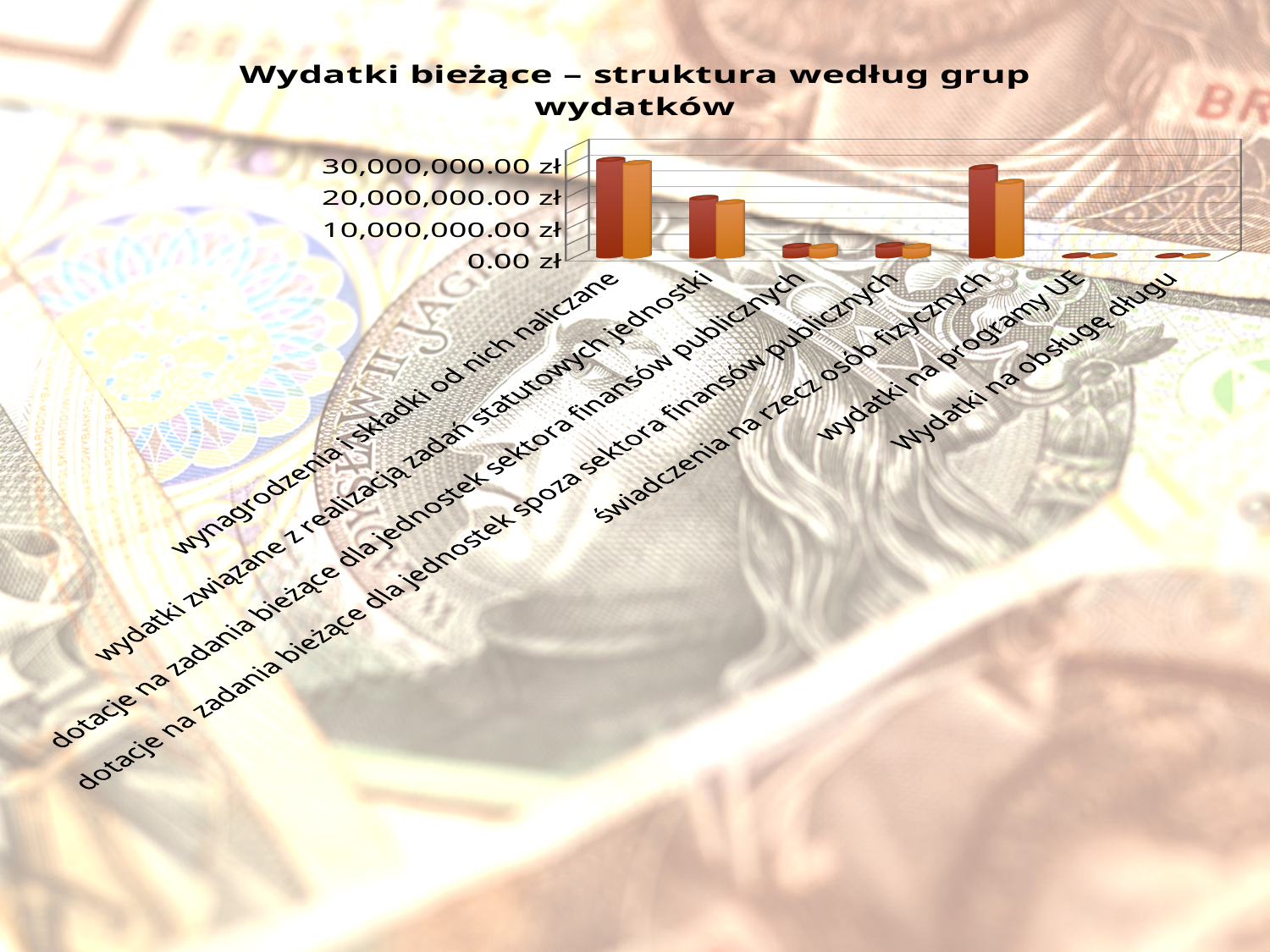
Which is larger: the value for 'wynagrodzenia i składki od nich naliczane' or for 'wydatki związane z realizacją zadań statutowych jednostki'? wynagrodzenia i składki od nich naliczane Which category has the highest bars in the chart? wynagrodzenia i składki od nich naliczane Is the value for 'świadczenia na rzecz osób fizycznych' greater or less than 10,000,000.00 zł? greater What is the title of the chart? Wydatki bieżące – struktura według grup wydatków Which category has the lowest bars in the chart? Wydatki na obsługę długu Is the value for 'wydatki na programy UE' greater or less than 20,000,000.00 zł? less How many expenditure categories are shown on the x axis of the chart? 7 Is the value for 'wydatki związane z realizacją zadań statutowych jednostki' greater or less than 20,000,000.00 zł? less What kind of chart is shown on the slide? bar chart Which is larger: the value for 'wydatki na programy UE' or for 'świadczenia na rzecz osób fizycznych'? świadczenia na rzecz osób fizycznych